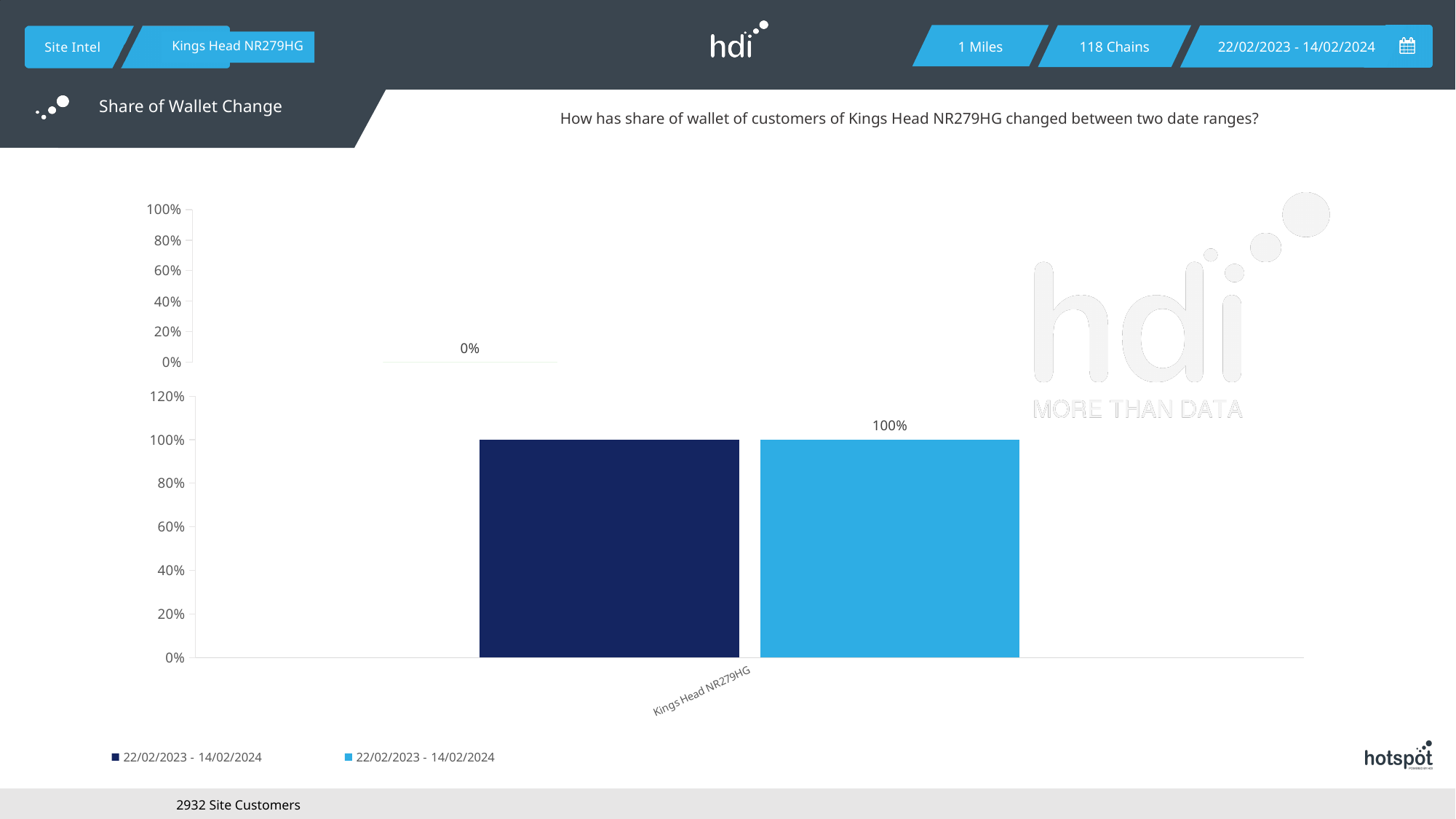
What is the category label shown on the x axis of the lower chart? Kings Head NR279HG In the lower chart, is the value of the dark blue bar for Kings Head NR279HG greater or less than 60%? greater In the lower chart, is the value of the light blue bar for Kings Head NR279HG greater or less than 80%? greater In the lower chart, how many categories are shown on the x axis? 1 In the upper chart, what value is printed as the data label? 0% What date range is shown as the first legend entry? 22/02/2023 - 14/02/2024 In the lower chart, what value does the dark blue bar for Kings Head NR279HG reach on the y axis? 100% How many series does the legend at the bottom of the slide list? 2 In the lower chart, what value is labelled on the light blue bar for Kings Head NR279HG? 100% What kind of chart is the lower chart on the slide? bar chart In the lower chart, what is the difference between the light blue bar and the dark blue bar for Kings Head NR279HG? 0%